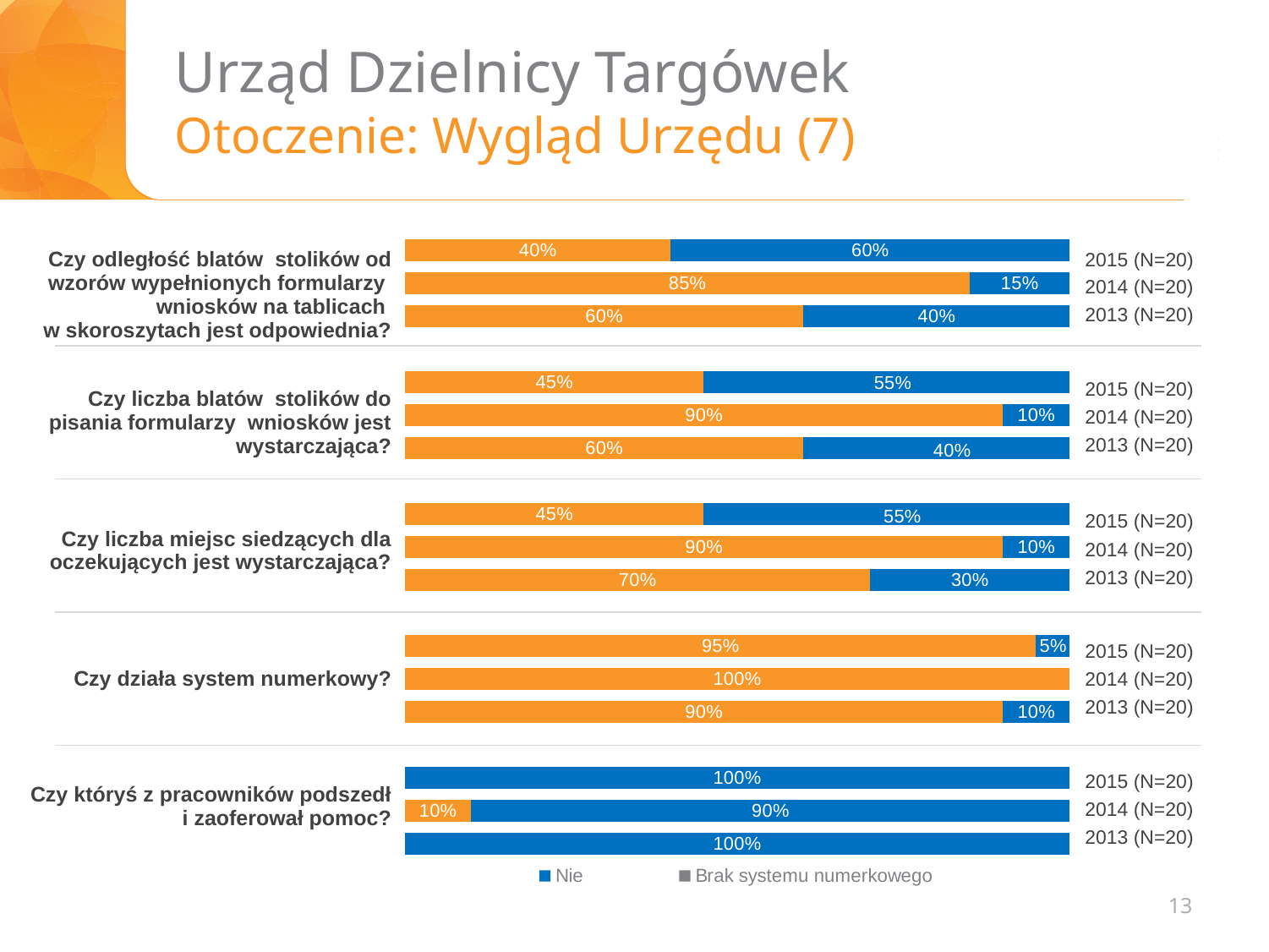
In the chart for "Czy działa system numerkowy?", which year has the lowest orange segment value? 2013 (N=20) In the chart for "Czy odległość blatów stolików od wzorów wypełnionych formularzy wniosków na tablicach w skoroszytach jest odpowiednia?", what is the "Nie" value for 2015 (N=20)? 60% In the chart for "Czy odległość blatów stolików od wzorów wypełnionych formularzy wniosków na tablicach w skoroszytach jest odpowiednia?", what is the difference between the orange segment values for 2014 (N=20) and 2015 (N=20)? 45% In the chart for "Czy któryś z pracowników podszedł i zaoferował pomoc?", what is the "Nie" value for 2014 (N=20)? 90% Which legend entry is shown with a blue marker? Nie How many years are shown in the chart for "Czy działa system numerkowy?"? 3 In the chart for "Czy liczba blatów stolików do pisania formularzy wniosków jest wystarczająca?", what is the total of the stacked bar for 2014 (N=20)? 100% In the chart for "Czy liczba miejsc siedzących dla oczekujących jest wystarczająca?", what is the "Nie" value for 2013 (N=20)? 30% In the chart for "Czy działa system numerkowy?", what is the value of the orange segment for 2015 (N=20)? 95% What kind of chart is used on this slide? Stacked bar chart In the chart for "Czy liczba blatów stolików do pisania formularzy wniosków jest wystarczająca?", which year has the highest "Nie" value? 2015 (N=20) In the chart for "Czy liczba miejsc siedzących dla oczekujących jest wystarczająca?", is the "Nie" value larger for 2015 (N=20) or 2013 (N=20)? 2015 (N=20)